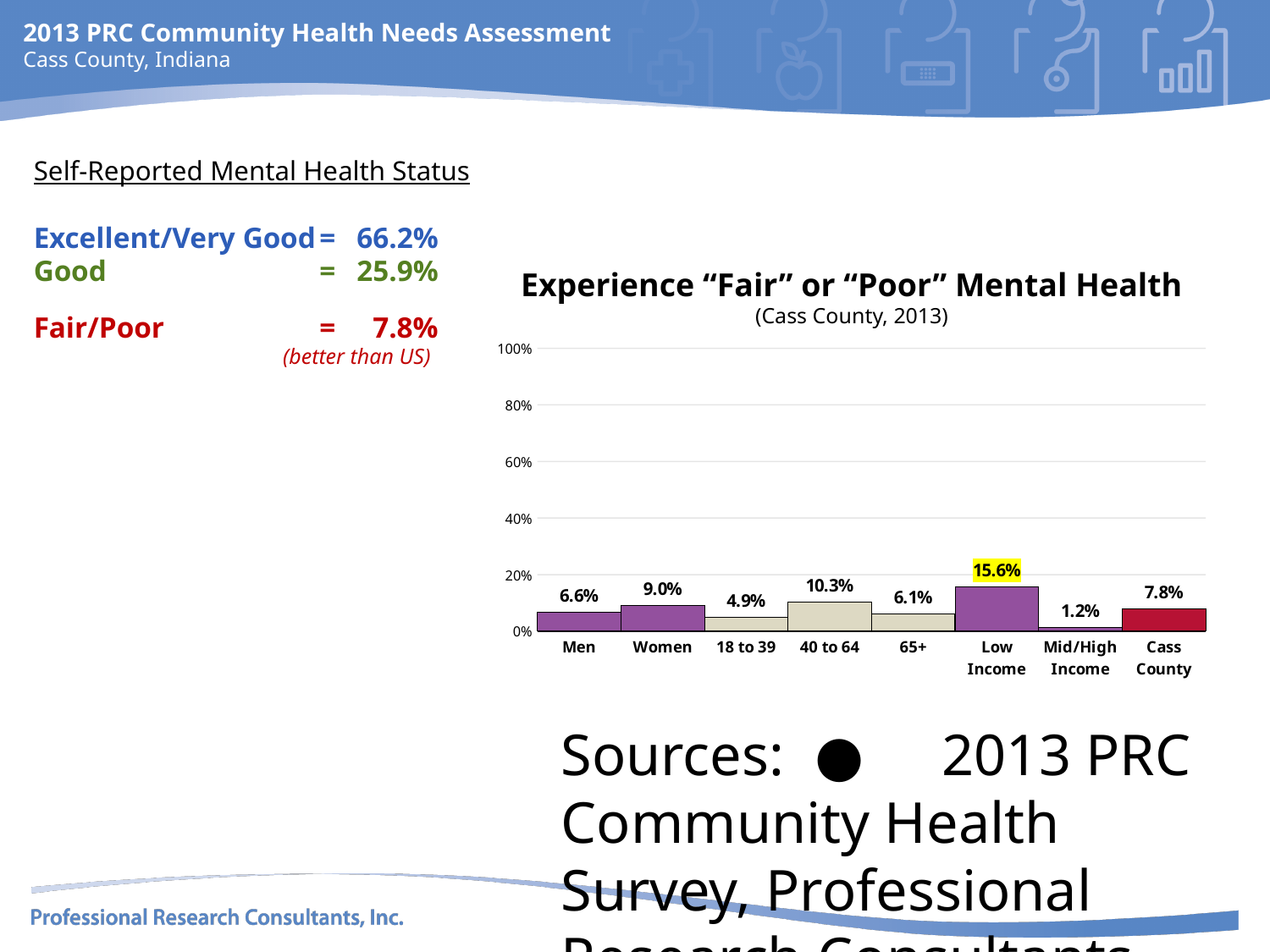
What is the difference between the values for 40 to 64 and 18 to 39? 5.4% What is the value for Women in the chart? 9.0% What is the difference between the values for Low Income and Mid/High Income? 14.4% Is the value for Cass County greater or less than 20%? less What is the value for 40 to 64 in the chart? 10.3% Which category has the lowest value in the chart? Mid/High Income Which is larger, the value for Men or the value for Women? Women What kind of chart is shown on the slide? bar chart Which category has the highest value in the chart? Low Income What is the value for Low Income in the chart? 15.6% How many categories are shown on the x axis of the chart? 8 What is the title of the chart? Experience "Fair" or "Poor" Mental Health